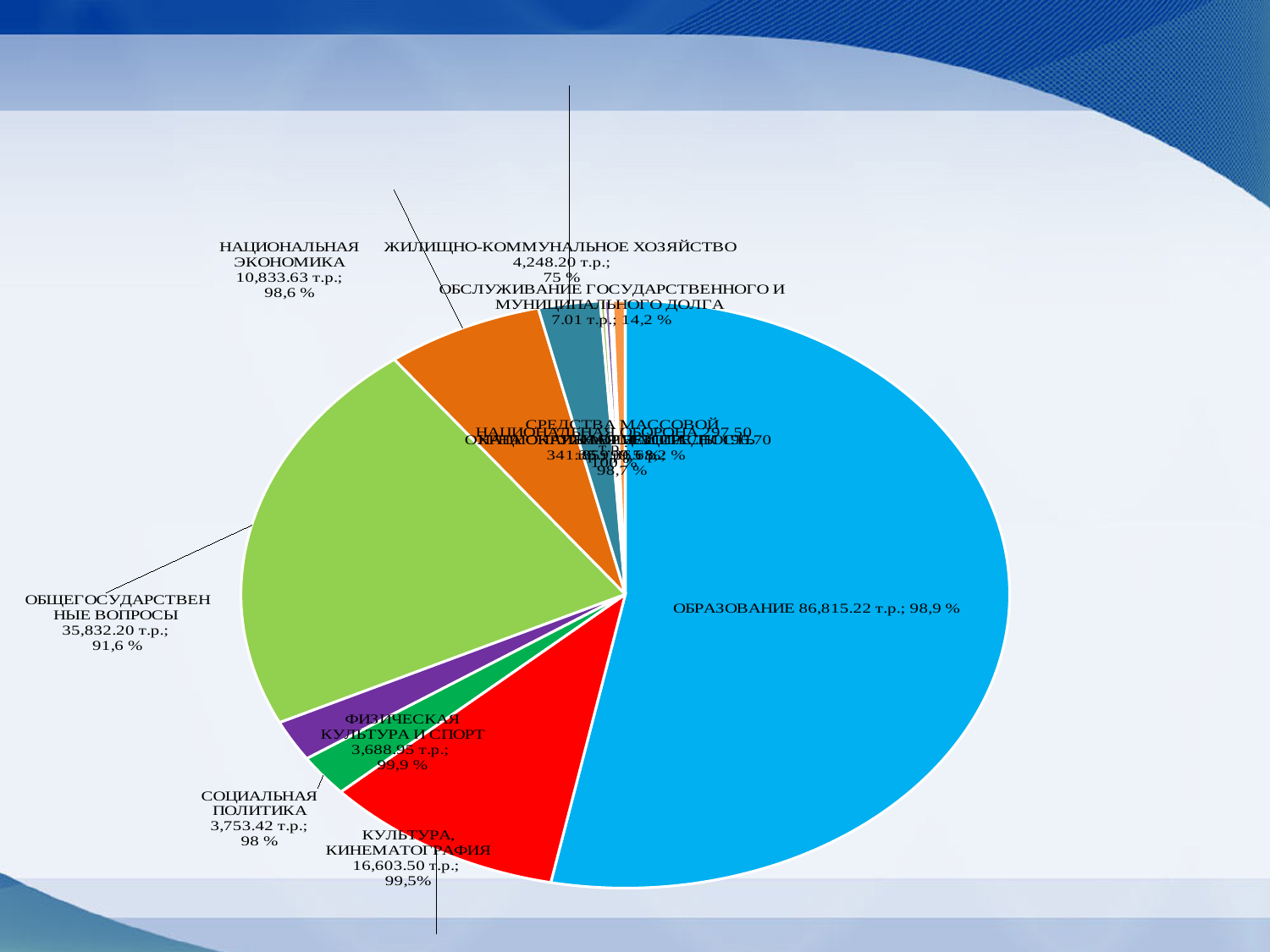
Which is larger in т.р.: СОЦИАЛЬНАЯ ПОЛИТИКА or ФИЗИЧЕСКАЯ КУЛЬТУРА И СПОРТ? СОЦИАЛЬНАЯ ПОЛИТИКА What is the difference in т.р. between СОЦИАЛЬНАЯ ПОЛИТИКА and ФИЗИЧЕСКАЯ КУЛЬТУРА И СПОРТ? 64.47 т.р. What percentage is shown for КУЛЬТУРА, КИНЕМАТОГРАФИЯ? 99,5% What value is shown for ОБРАЗОВАНИЕ? 86,815.22 т.р.; 98,9 % What is the difference in т.р. between ОБРАЗОВАНИЕ and ОБЩЕГОСУДАРСТВЕННЫЕ ВОПРОСЫ? 50,983.02 т.р. What percentage is shown for ЖИЛИЩНО-КОММУНАЛЬНОЕ ХОЗЯЙСТВО? 75 % What type of chart is shown on the slide? pie chart What value is shown for ОБСЛУЖИВАНИЕ ГОСУДАРСТВЕННОГО И МУНИЦИПАЛЬНОГО ДОЛГА? 7.01 т.р.; 14,2 % What amount in т.р. is shown for НАЦИОНАЛЬНАЯ ЭКОНОМИКА? 10,833.63 т.р. Which category has the largest slice of the pie? ОБРАЗОВАНИЕ What colour is the slice for ОБРАЗОВАНИЕ? blue What amount in т.р. is shown for ОБЩЕГОСУДАРСТВЕННЫЕ ВОПРОСЫ? 35,832.20 т.р.